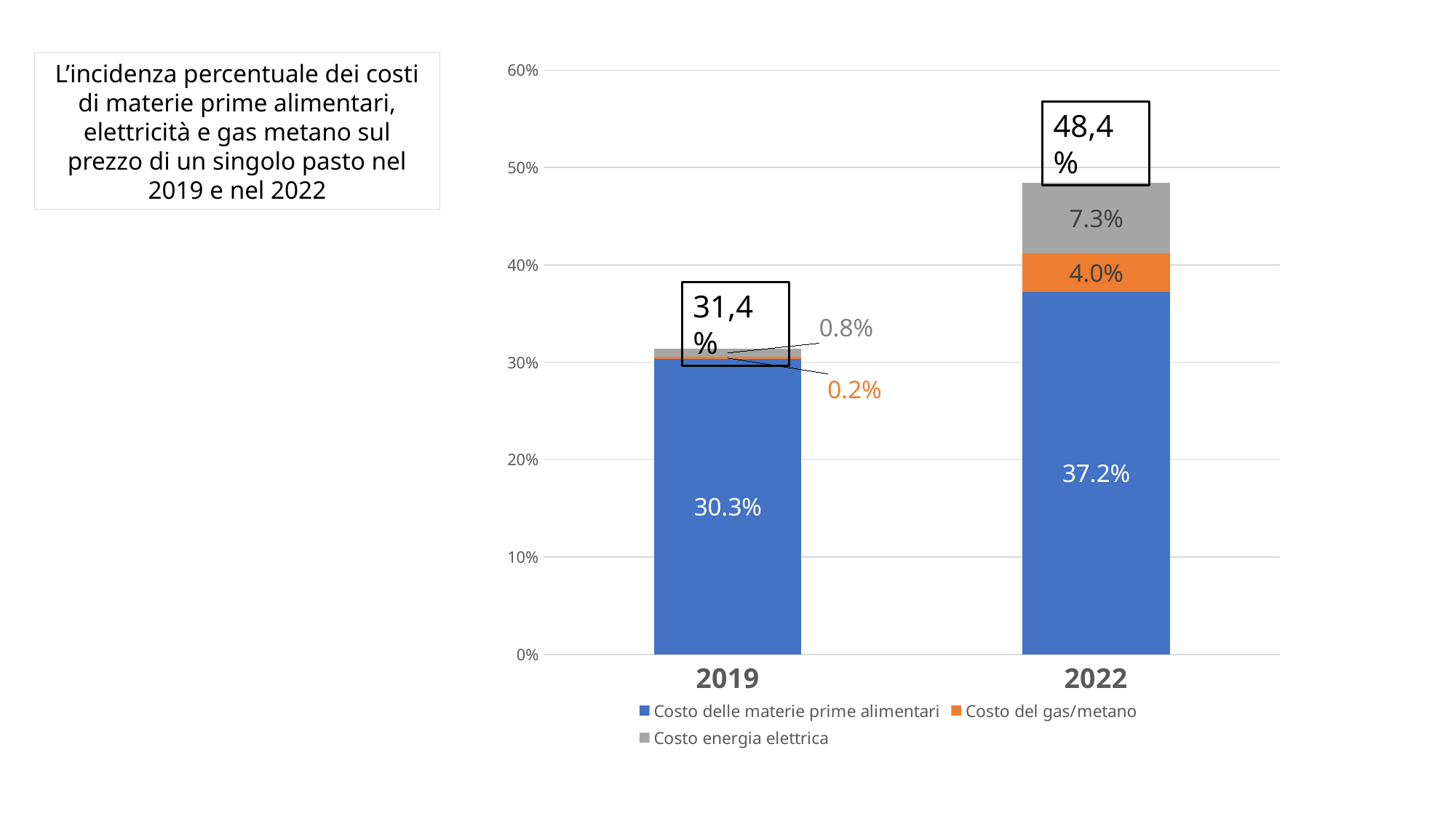
What is the value of Costo delle materie prime alimentari for 2019? 30.3% By how many percentage points did Costo energia elettrica increase from 2019 to 2022? 6.5 Which year has the higher value for Costo delle materie prime alimentari, 2019 or 2022? 2022 What type of chart is shown on the slide? Stacked bar chart What is the total of the stacked bar for 2019? 31,4% How many series does the legend list? 3 What is the value of Costo del gas/metano for 2019? 0.2% Which colour represents Costo energia elettrica in the chart? Gray What is the value of Costo delle materie prime alimentari for 2022? 37.2% What is the total of the stacked bar for 2022? 48,4% What is the value of Costo energia elettrica for 2019? 0.8% What is the value of Costo del gas/metano for 2022? 4.0%